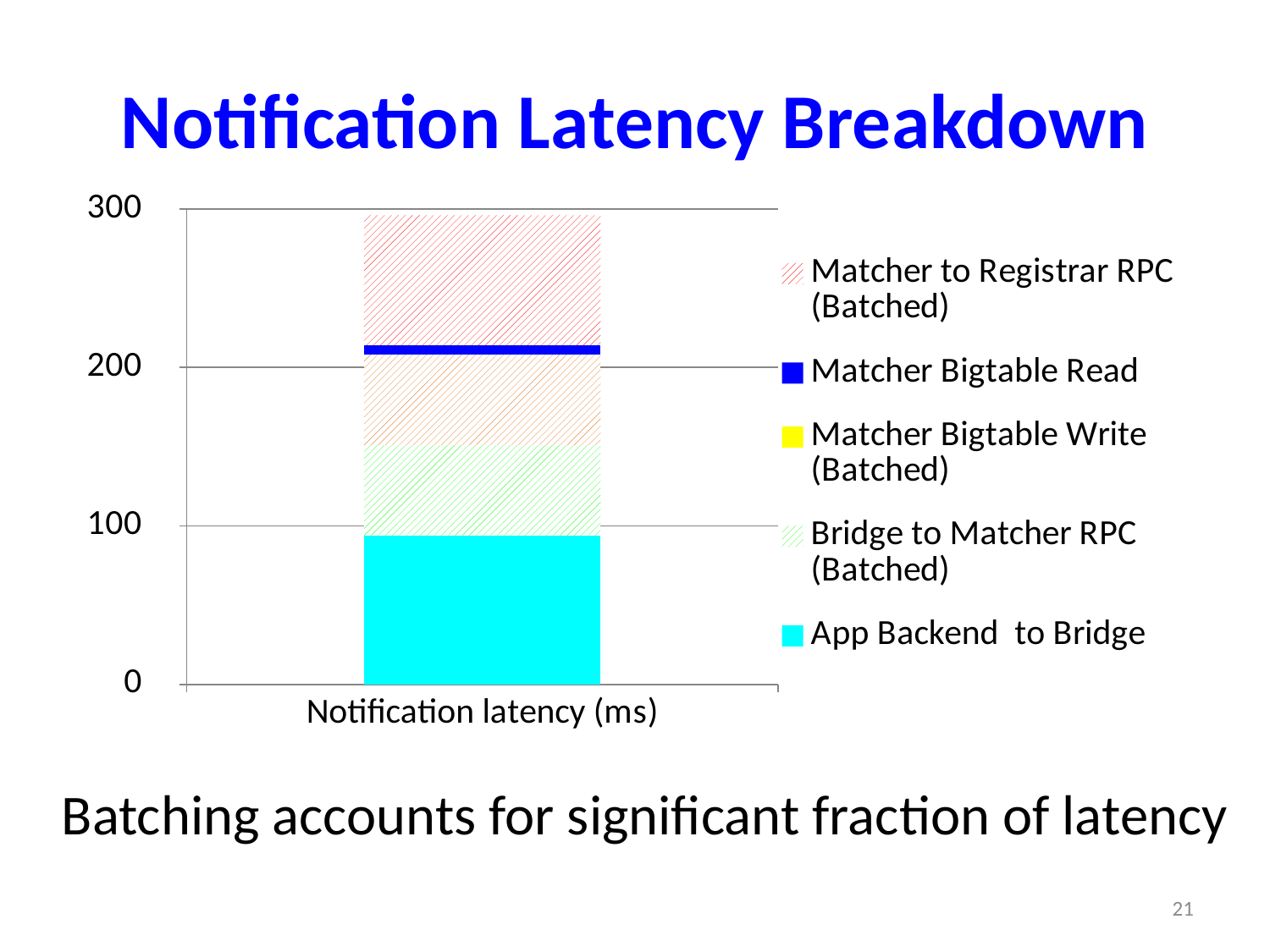
Is the total height of the stacked bar greater or less than 200? greater Is the value of the App Backend to Bridge segment greater or less than 100? less How many series does the legend list? 5 What is the label on the x axis of the chart? Notification latency (ms) Which segment is larger, App Backend to Bridge or Matcher Bigtable Read? App Backend to Bridge What is the title of the chart on the slide? Notification Latency Breakdown What kind of chart is shown on the slide? stacked bar chart What is the highest value shown on the y axis? 300 Which segment is larger, Matcher to Registrar RPC (Batched) or Matcher Bigtable Read? Matcher to Registrar RPC (Batched) How many bars are plotted in the chart? 1 Is the value of the Matcher Bigtable Read segment greater or less than 100? less